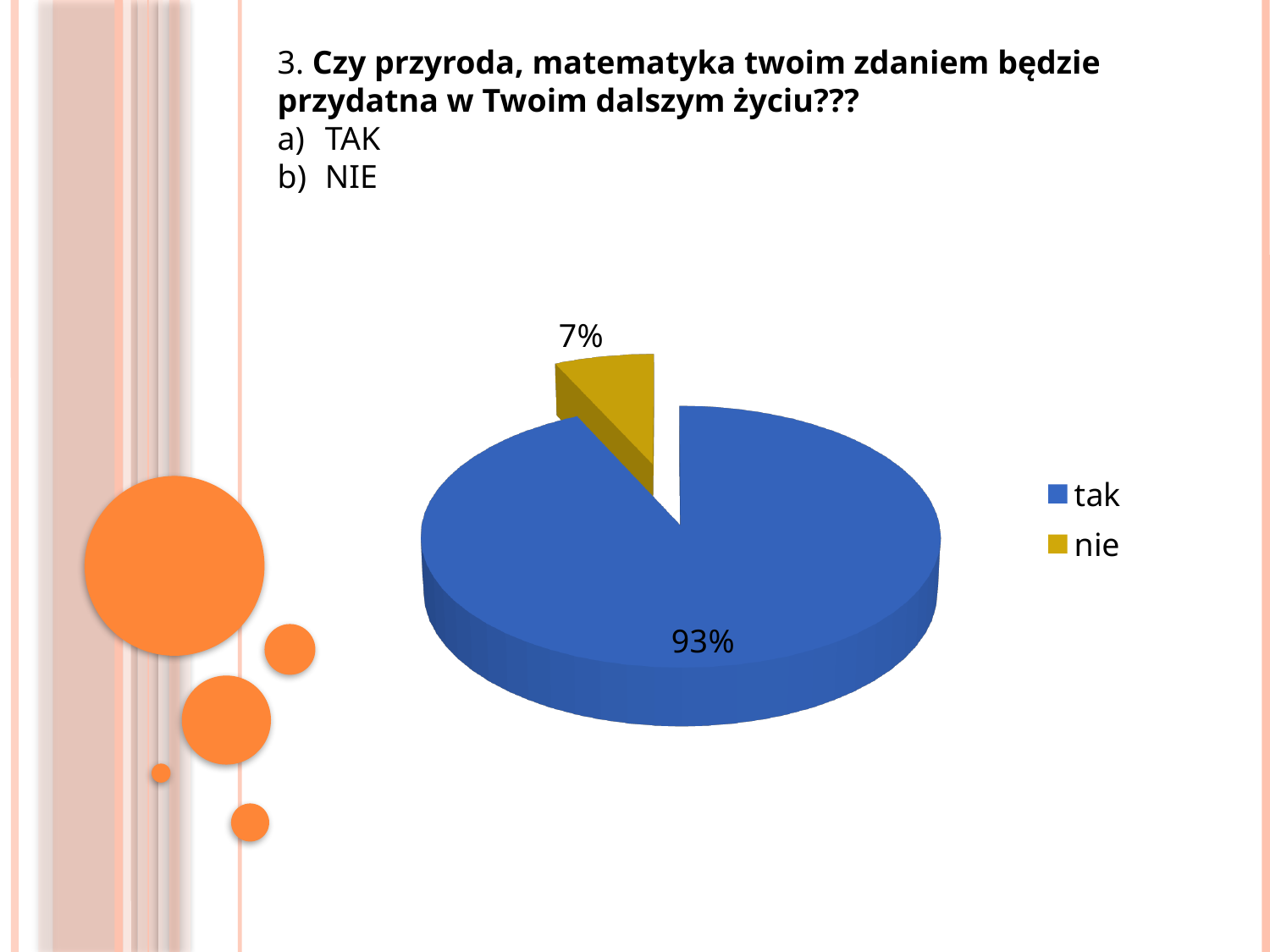
Is the share of the "tak" slice greater or less than 50%? greater How many slices does the pie chart have? 2 What is the difference in percentage points between the "tak" and "nie" slices? 86 Which slice is the smallest in the pie chart? nie What kind of chart is shown on the slide? pie chart What colour is the "tak" slice? blue What percentage of the pie is the "nie" slice? 7% Which slice is larger, "tak" or "nie"? tak Which slice is the largest in the pie chart? tak What percentage of the pie is the "tak" slice? 93% What colour is the "nie" slice? yellow How many entries does the legend list? 2